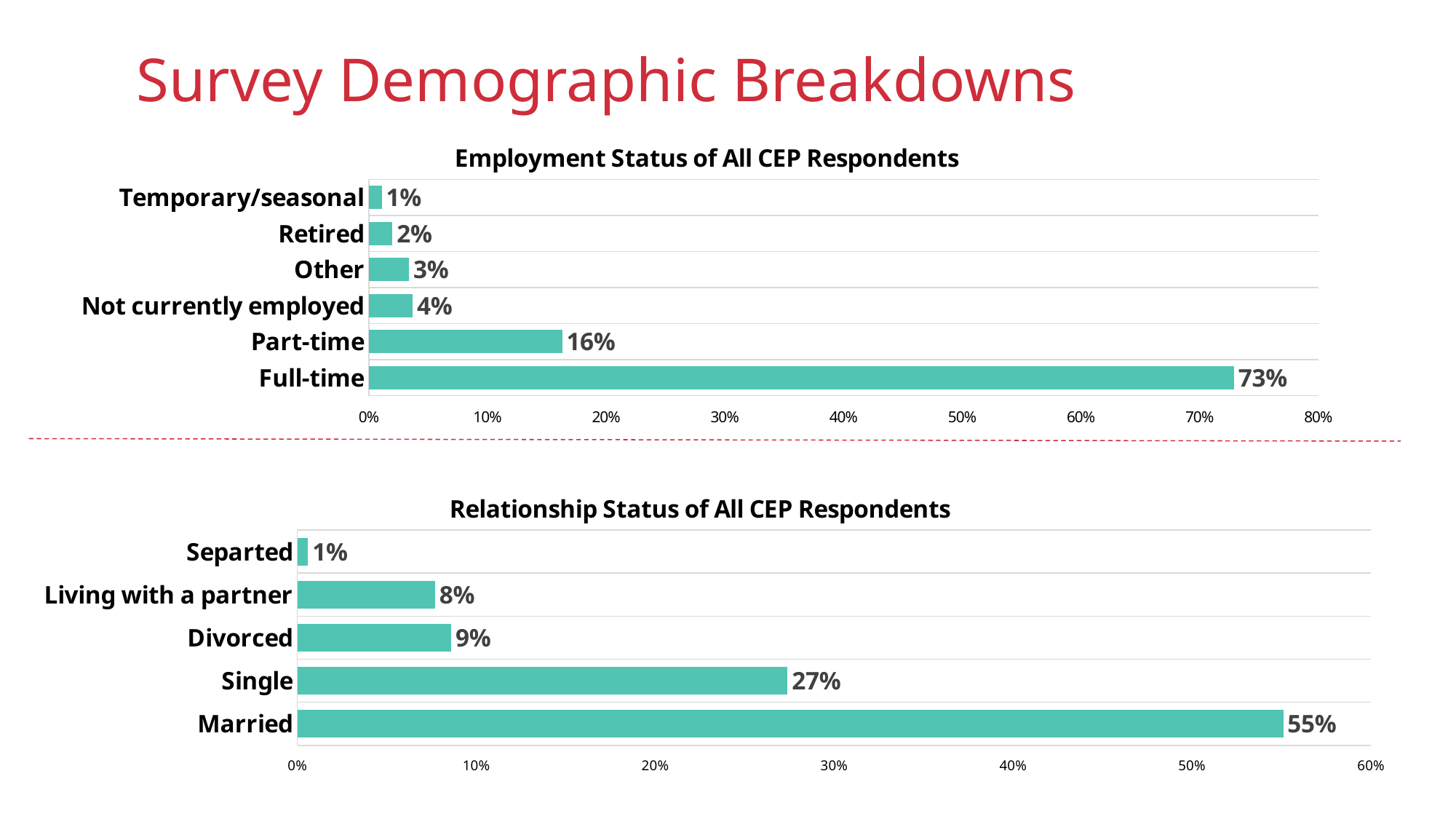
In the Relationship Status of All CEP Respondents chart, which category has the highest value? Married In the Relationship Status of All CEP Respondents chart, what is the difference between Married and Single? 28% In the Employment Status of All CEP Respondents chart, which is larger, Other or Not currently employed? Not currently employed In the Relationship Status of All CEP Respondents chart, what is the value for Married? 55% What kind of chart is the Relationship Status of All CEP Respondents chart? Bar chart In the Relationship Status of All CEP Respondents chart, what is the value for Single? 27% In the Employment Status of All CEP Respondents chart, what is the difference between Full-time and Part-time? 57% In the Employment Status of All CEP Respondents chart, what is the value for Part-time? 16% In the Relationship Status of All CEP Respondents chart, how many categories are shown? 5 In the Employment Status of All CEP Respondents chart, how many categories are shown? 6 In the Employment Status of All CEP Respondents chart, which category has the lowest value? Temporary/seasonal In the Employment Status of All CEP Respondents chart, what is the value for Full-time? 73%